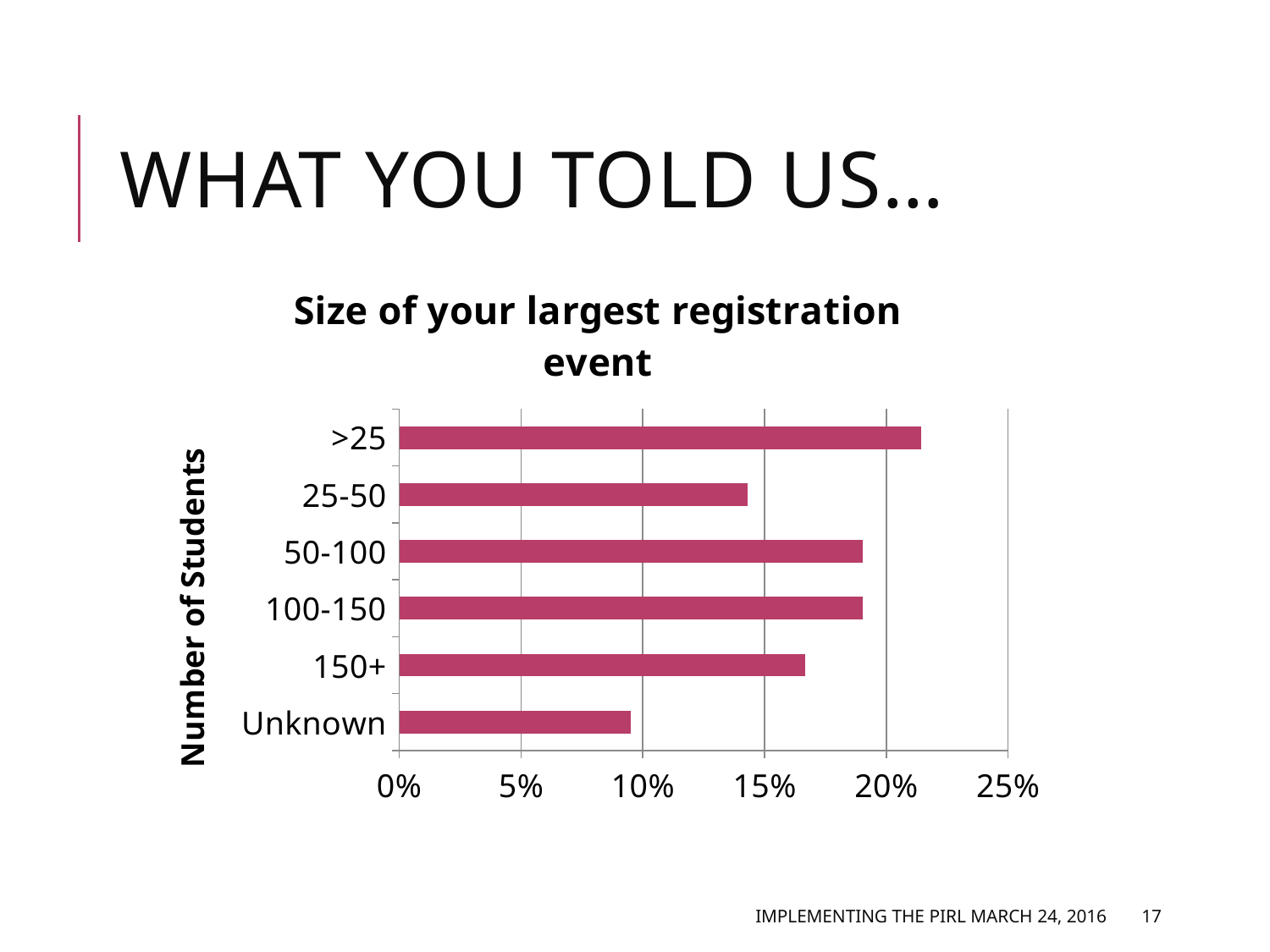
Which category has the highest value? >25 Which is larger, the value for >25 or the value for 25-50? >25 What kind of chart is shown on the slide? bar chart How many categories are plotted in the chart? 6 Which category has the lowest value? Unknown What is the label on the vertical axis of the chart? Number of Students Is the value for 150+ greater or less than 15%? greater What is the title of the chart? Size of your largest registration event Is the value for Unknown greater or less than 10%? less Which is larger, the value for 150+ or the value for Unknown? 150+ Is the value for >25 greater or less than 20%? greater